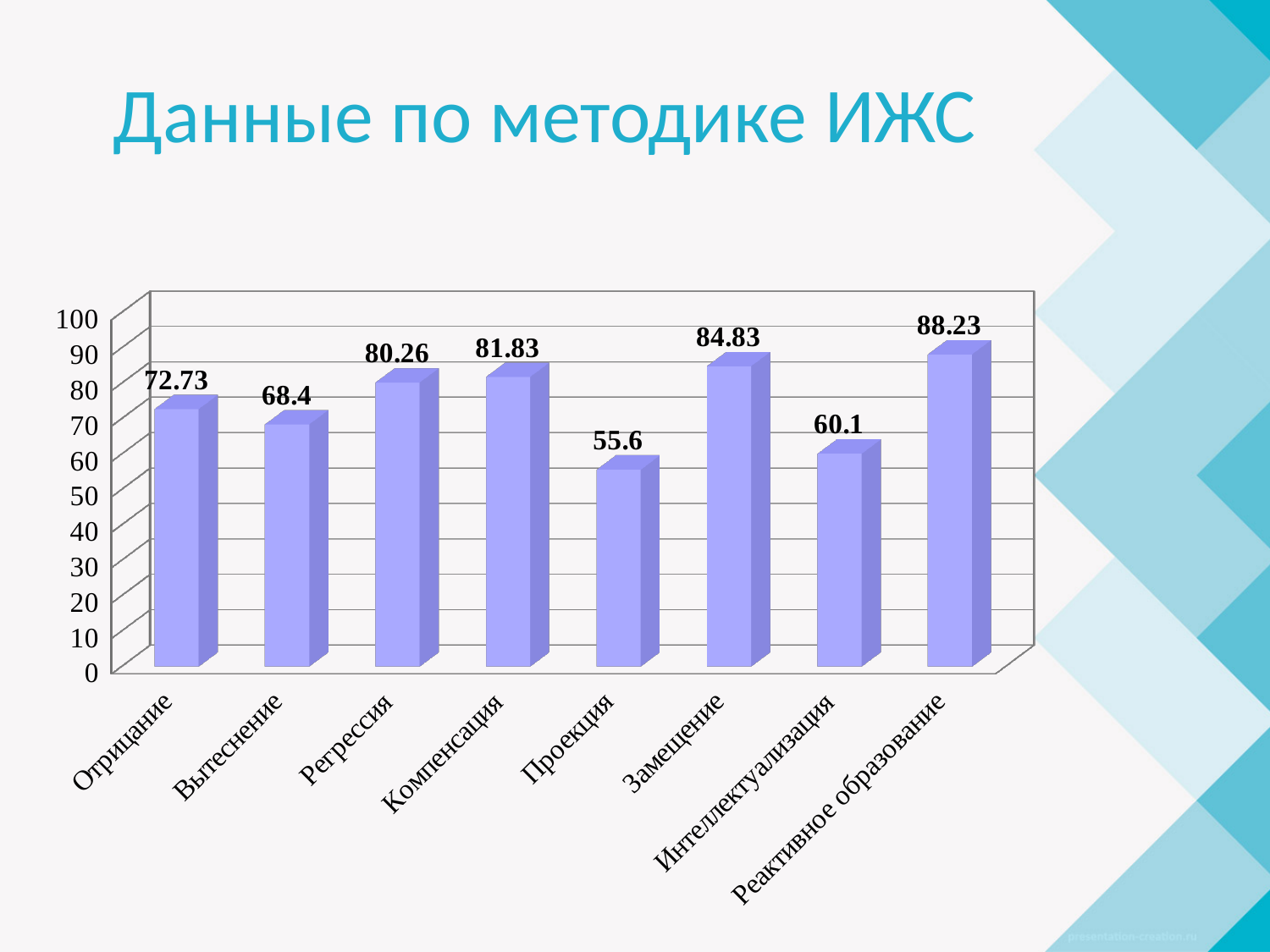
How many categories are shown on the chart? 8 What is the title of the slide? Данные по методике ИЖС What kind of chart is shown on the slide? bar chart Which category has the highest value? Реактивное образование Which category has the lowest value? Проекция Is the value for Компенсация greater or less than 80? greater Which is larger, the value for Регрессия or the value for Отрицание? Регрессия What is the value for Проекция? 55.6 What is the difference between the values for Реактивное образование and Проекция? 32.63 What is the value for Интеллектуализация? 60.1 What is the value for Отрицание? 72.73 What is the difference between the values for Замещение and Вытеснение? 16.43